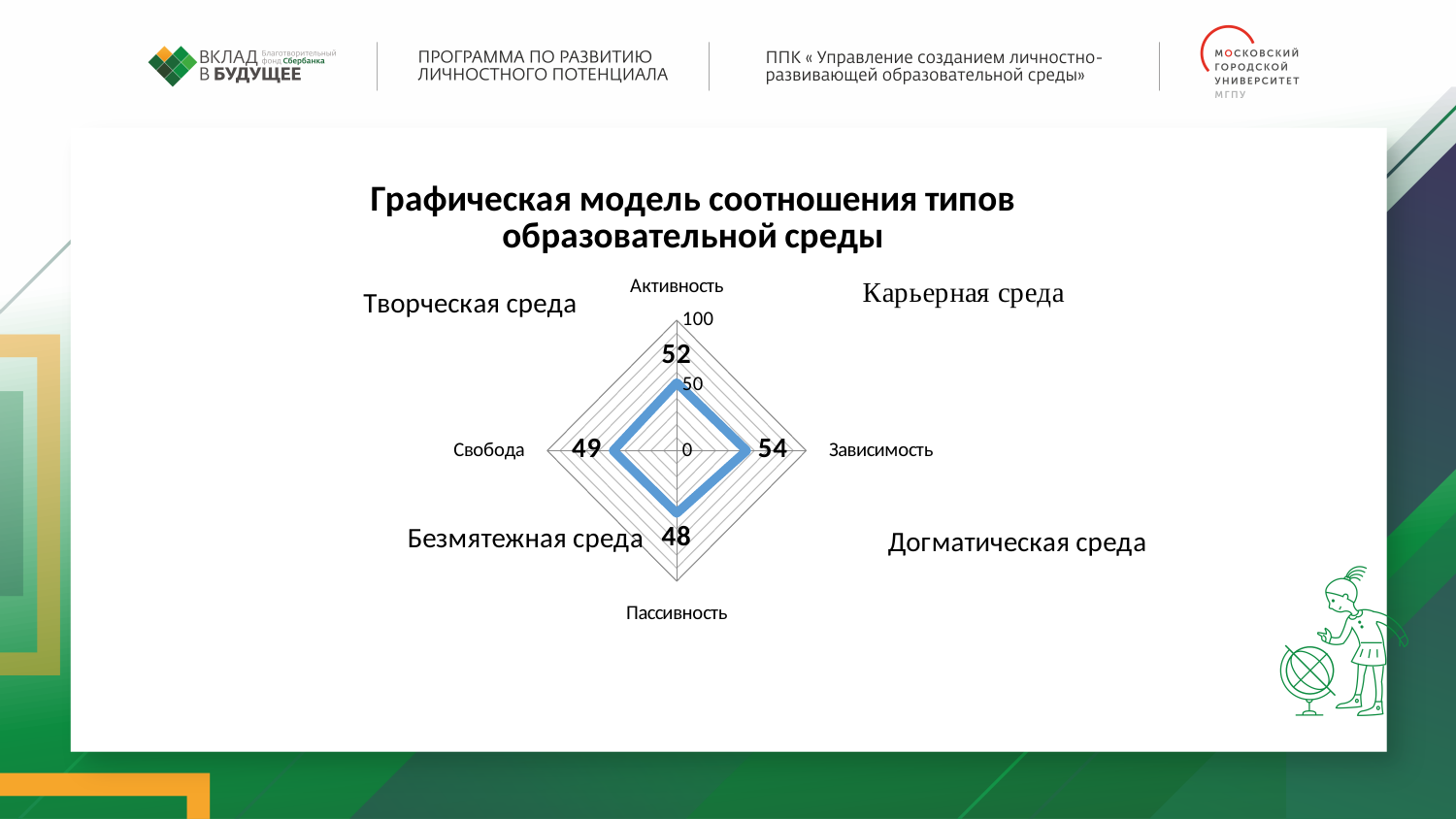
What is the value for Пассивность on the radar chart? 48 What is the maximum value shown on the radar chart's axis scale? 100 What is the difference between the values for Зависимость and Пассивность? 6 How many axes (categories) does the radar chart have? 4 What is the value for Активность on the radar chart? 52 Which axis has the lowest value on the radar chart? Пассивность What is the value for Зависимость on the radar chart? 54 Which axis has the highest value on the radar chart? Зависимость What is the difference between the values for Активность and Свобода? 3 Which is larger, the value for Активность or the value for Пассивность? Активность What is the value for Свобода on the radar chart? 49 What kind of chart is shown on the slide? Radar chart